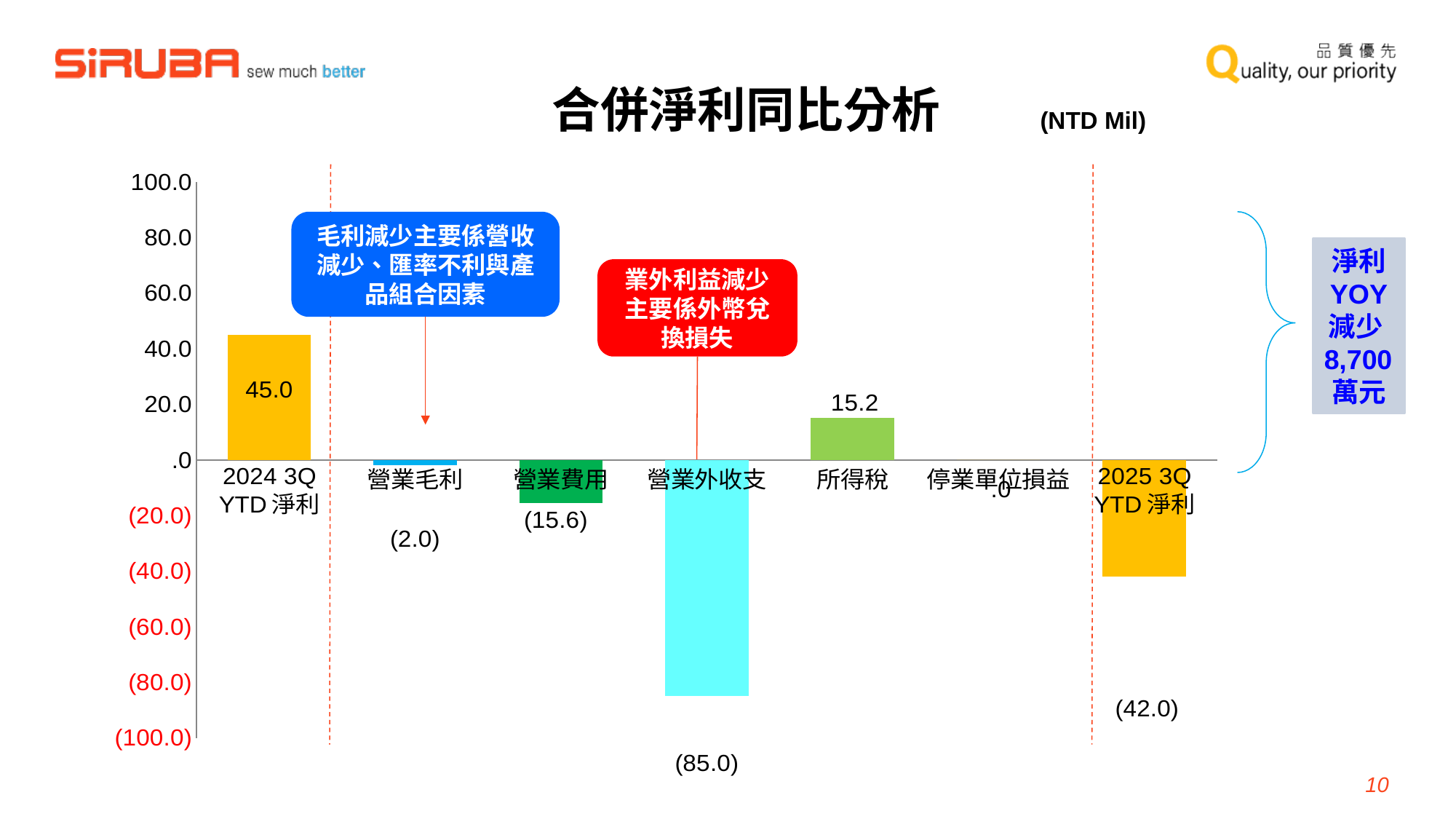
What is the value shown for 營業外收支? (85.0) Which category has the lowest value on the chart? 營業外收支 What is the value shown for 停業單位損益? .0 Which category has the highest value on the chart? 2024 3Q YTD 淨利 What is the value shown for 2024 3Q YTD 淨利? 45.0 What is the value shown for 營業費用? (15.6) What is the value shown for 所得稅? 15.2 What unit is stated next to the chart title? NTD Mil How many categories are shown on the x axis of the chart? 7 Which is larger in magnitude, the value for 營業費用 or the value for 營業毛利? 營業費用 What is the value shown for 2025 3Q YTD 淨利? (42.0) What kind of chart is shown on the slide? Bar chart